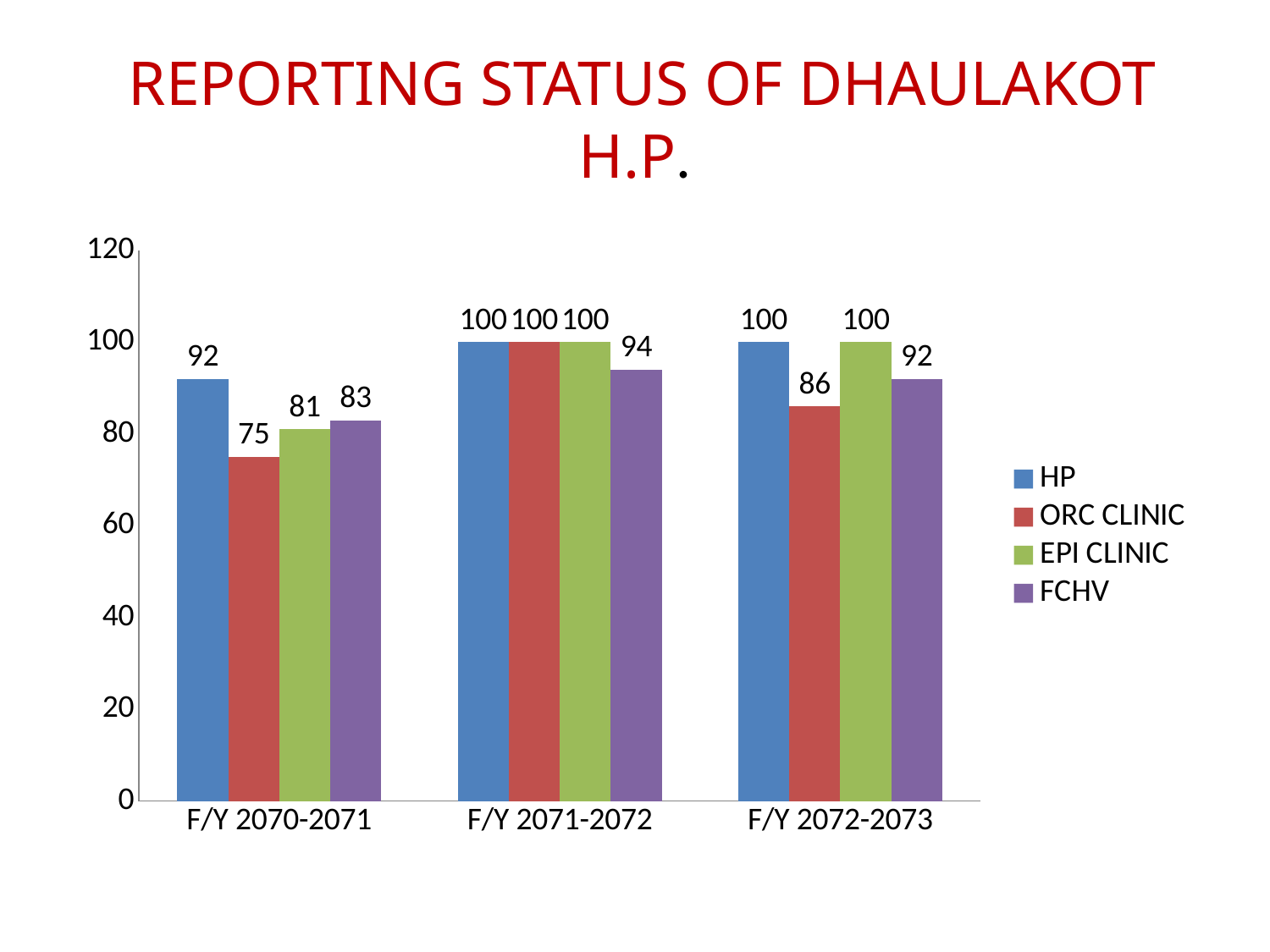
What is the value for HP in F/Y 2070-2071? 92 Which series has the lowest value in F/Y 2070-2071? ORC CLINIC What is the value for EPI CLINIC in F/Y 2072-2073? 100 What is the value for ORC CLINIC in F/Y 2070-2071? 75 What is the difference between the ORC CLINIC value in F/Y 2072-2073 and in F/Y 2070-2071? 11 Which series has the lowest value in F/Y 2072-2073? ORC CLINIC What kind of chart is shown on the slide? Bar chart What is the value for FCHV in F/Y 2071-2072? 94 Which is larger in F/Y 2070-2071, the EPI CLINIC value or the FCHV value? FCHV What is the difference between the HP value and the ORC CLINIC value in F/Y 2070-2071? 17 How many fiscal year categories are shown on the x axis? 3 How many series does the legend list? 4